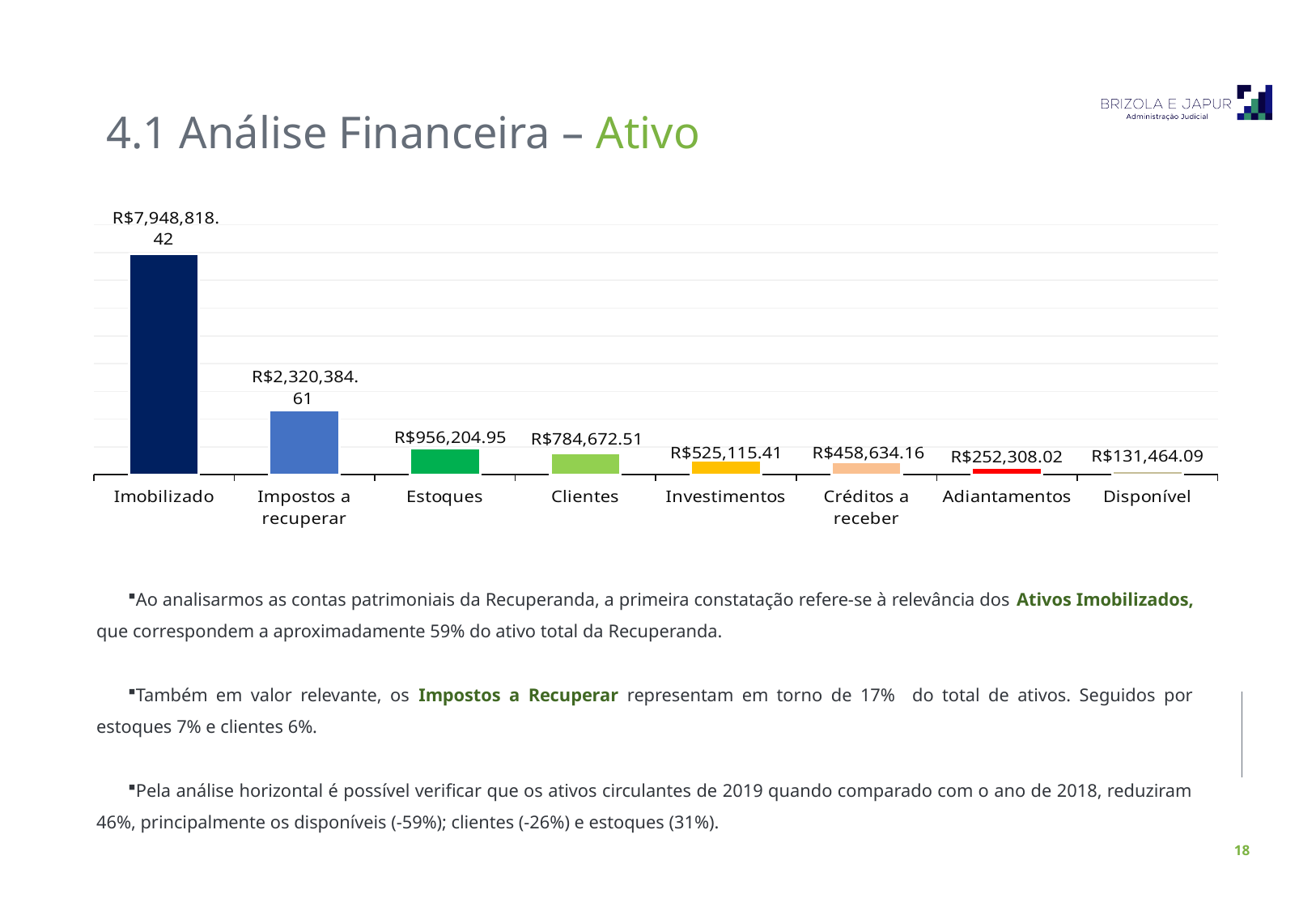
How many categories are shown in the chart? 8 Do the values rise or fall from left to right along the x axis? fall What is the difference between the values for Adiantamentos and Disponível? R$120,843.93 What is the value for Estoques? R$956,204.95 What is the difference between the values for Estoques and Clientes? R$171,532.44 What is the value for Disponível? R$131,464.09 What is the value for Impostos a recuperar? R$2,320,384.61 Which category has the lowest value? Disponível Which category has the highest value? Imobilizado What is the value for Investimentos? R$525,115.41 What is the value for Imobilizado? R$7,948,818.42 Which is larger, the value for Créditos a receber or the value for Investimentos? Investimentos